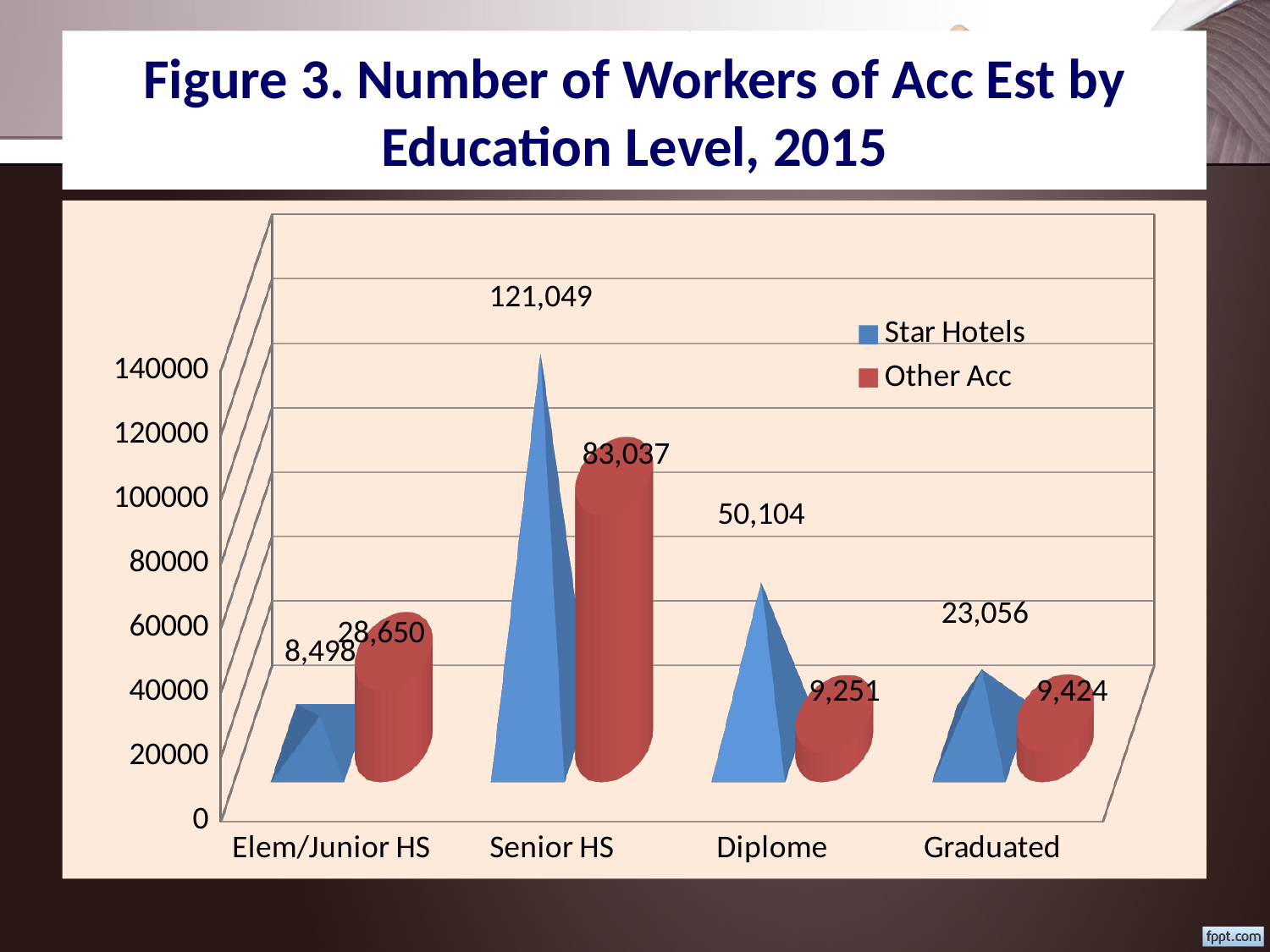
What is the value for Star Hotels in the Graduated category? 23,056 Which education level has the lowest number of Other Acc workers? Diplome What is the number of Other Acc workers with Elem/Junior HS education? 28,650 What kind of chart is shown on the slide? Bar chart How many education level categories are shown on the x axis? 4 How many series does the legend list? 2 Which education level has the highest number of Star Hotels workers? Senior HS What is the number of Star Hotels workers with Senior HS education? 121,049 What is the total of Star Hotels and Other Acc workers in the Graduated category? 32,480 What is the difference between Star Hotels and Other Acc workers in the Senior HS category? 38,012 In the Elem/Junior HS category, which series has the larger value, Star Hotels or Other Acc? Other Acc What is the value for Other Acc in the Diplome category? 9,251